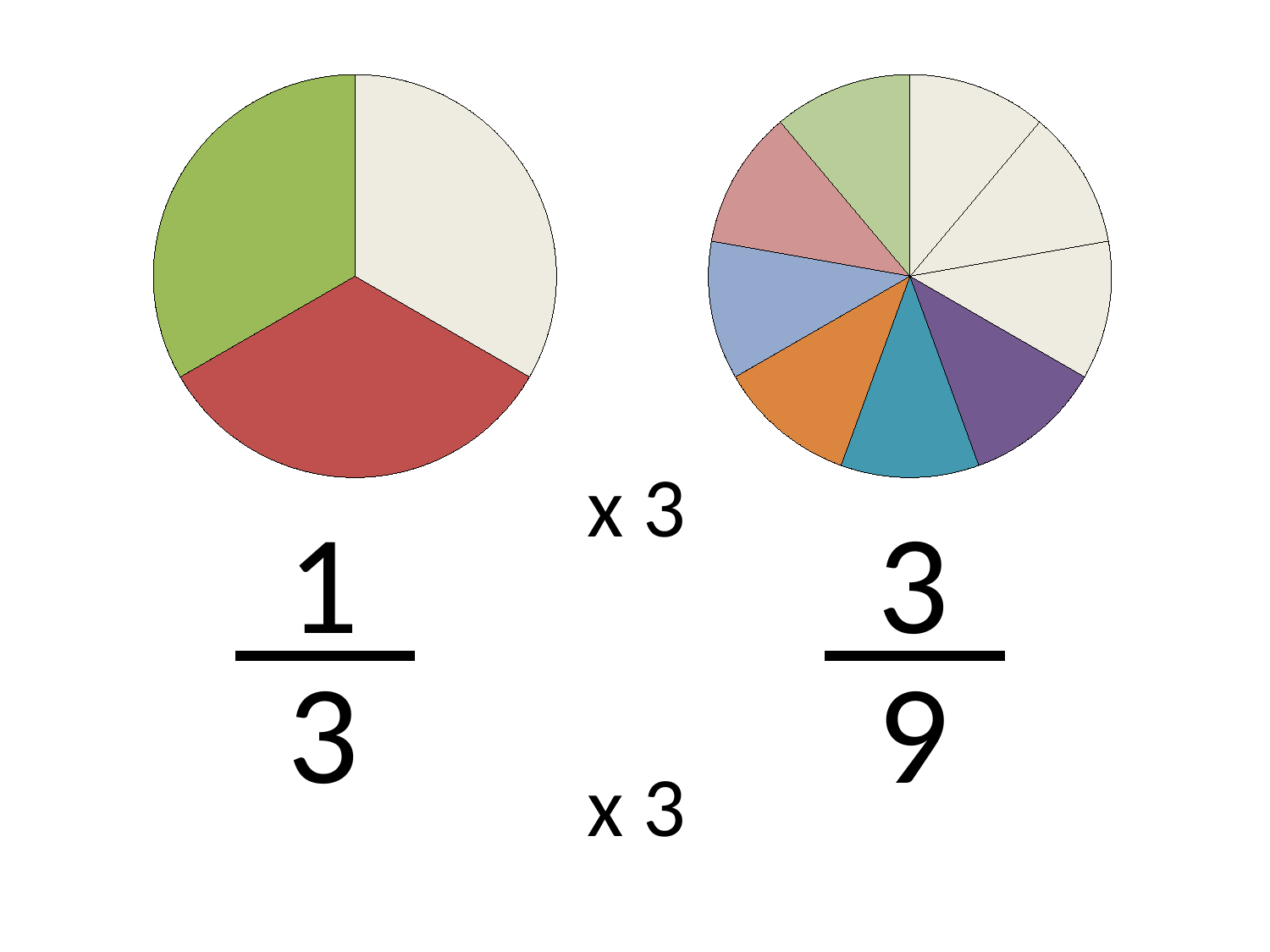
How many slices does the pie chart on the right of the slide have? 9 In the pie chart on the right of the slide, how many slices are coloured cream (unfilled)? 3 What fraction is printed below the pie chart on the left of the slide? 1/3 How many pie charts are shown on the slide? 2 What kind of chart is the chart on the left of the slide? pie chart What fraction is printed below the pie chart on the right of the slide? 3/9 What kind of chart is the chart on the right of the slide? pie chart In the pie chart on the left of the slide, what share of the pie does the green slice represent? 1/3 In the pie chart on the left of the slide, what share of the pie does the red slice represent? 1/3 How many slices does the pie chart on the left of the slide have? 3 In the pie chart on the left of the slide, are the three slices equal in size? yes